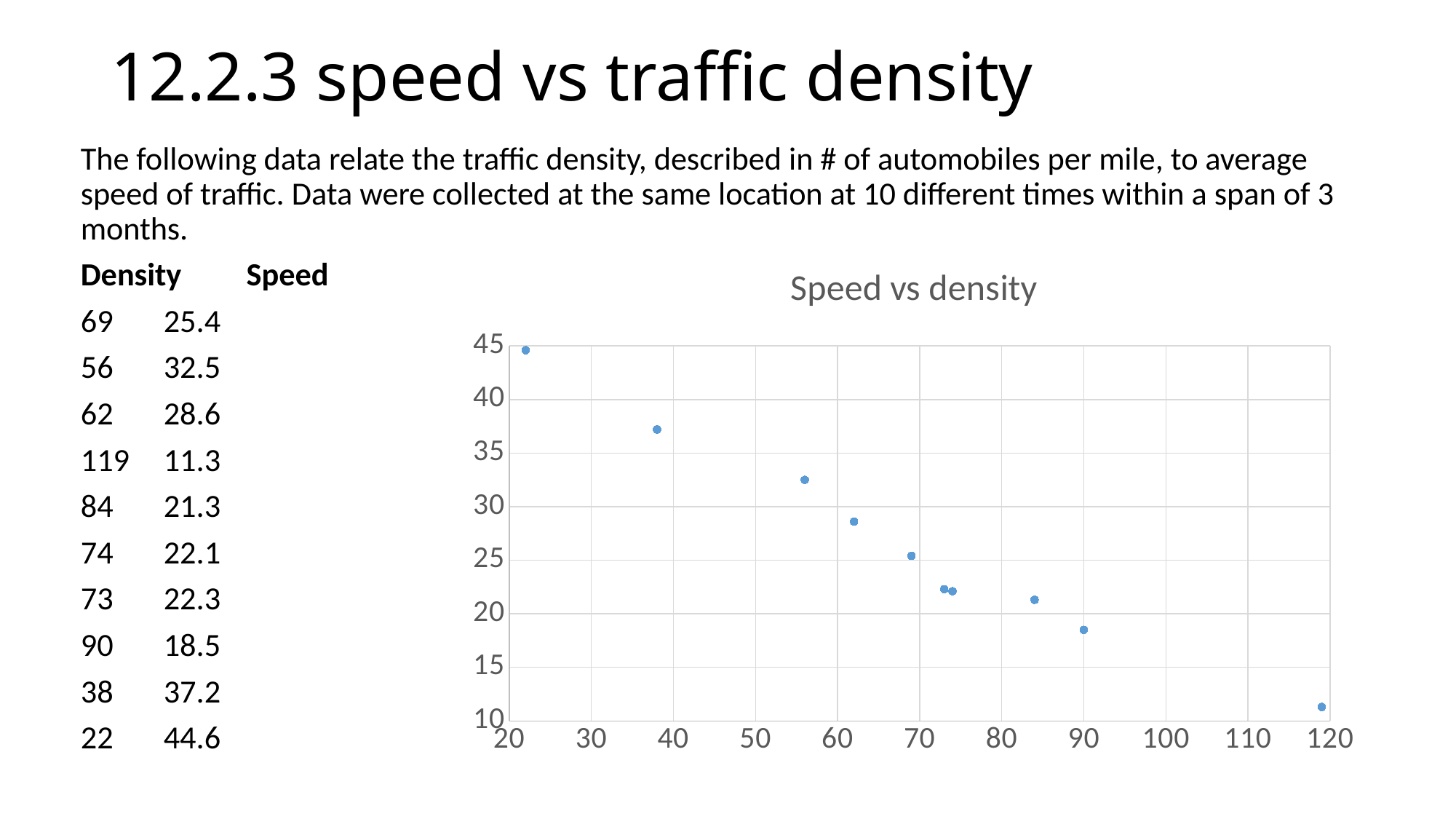
Which has the higher speed: the point at density 56 or the point at density 90? density 56 What type of chart is shown on the slide? scatter chart Is the speed at a density of 38 greater or less than 35? greater According to the data on the slide, what is the speed at a density of 62? 28.6 Which density value has the highest speed in the chart? 22 Is the speed at a density of 84 greater or less than 25? less Is the speed at a density of 119 greater or less than 15? less What is the title of the chart? Speed vs density How many data points are plotted in the Speed vs density chart? 10 Which density value has the lowest speed in the chart? 119 As density increases along the x axis, does speed rise or fall? fall